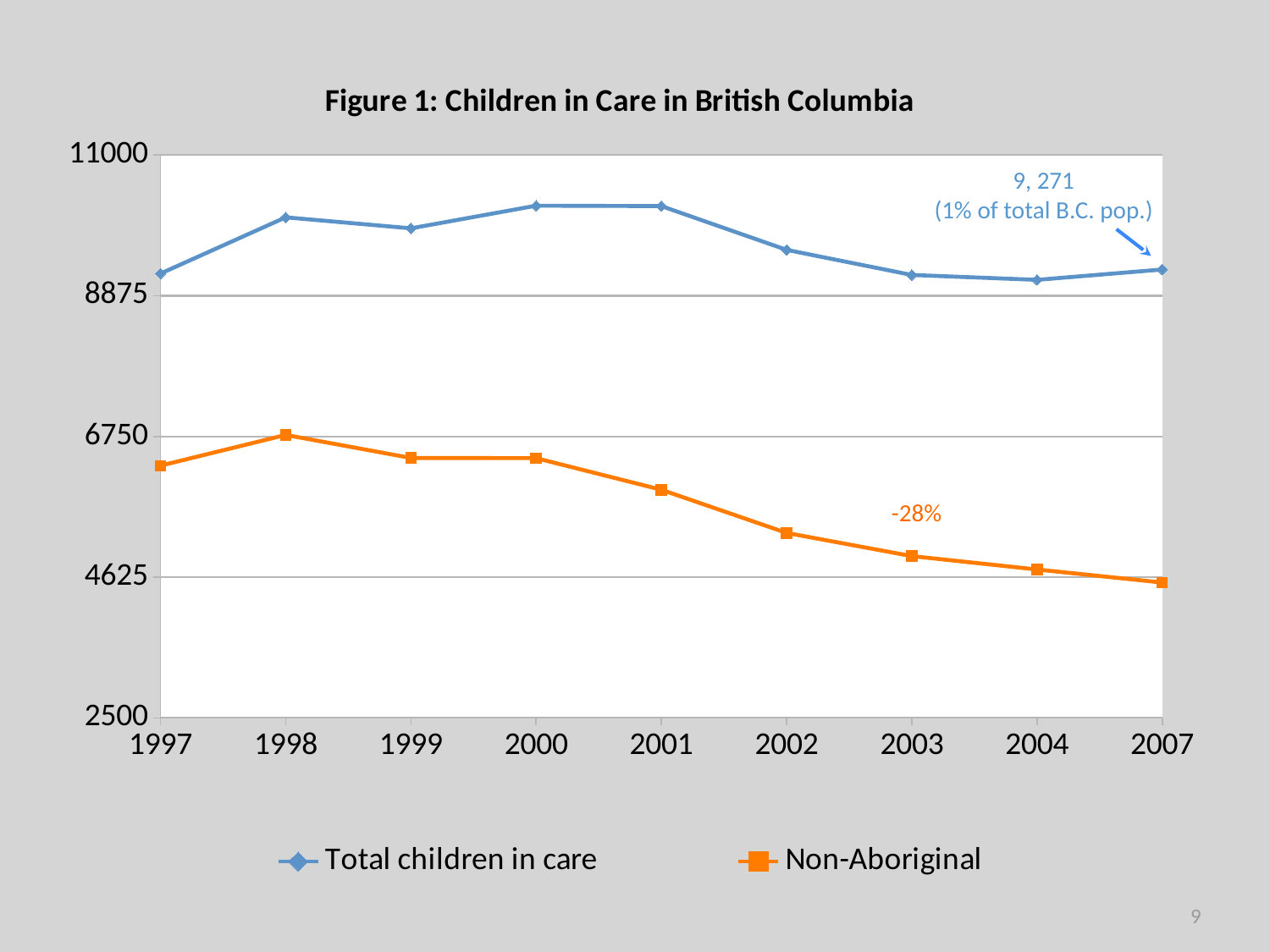
How many series does the legend list? 2 Is the value for Non-Aboriginal in 2001 greater or less than 6750? less Is the value for Total children in care in 1997 greater or less than 8875? greater How many years are plotted along the x axis? 9 In which year is the Non-Aboriginal series at its highest? 1998 Which series has the larger value in 2000, Total children in care or Non-Aboriginal? Total children in care What kind of chart is shown on the slide? line chart What is the title of the chart? Figure 1: Children in Care in British Columbia Does the Non-Aboriginal series rise or fall from 2001 to 2007? fall Is the value for Non-Aboriginal in 2002 greater or less than 4625? greater In which year is the Non-Aboriginal series at its lowest? 2007 What is the value for Total children in care in 2007? 9, 271